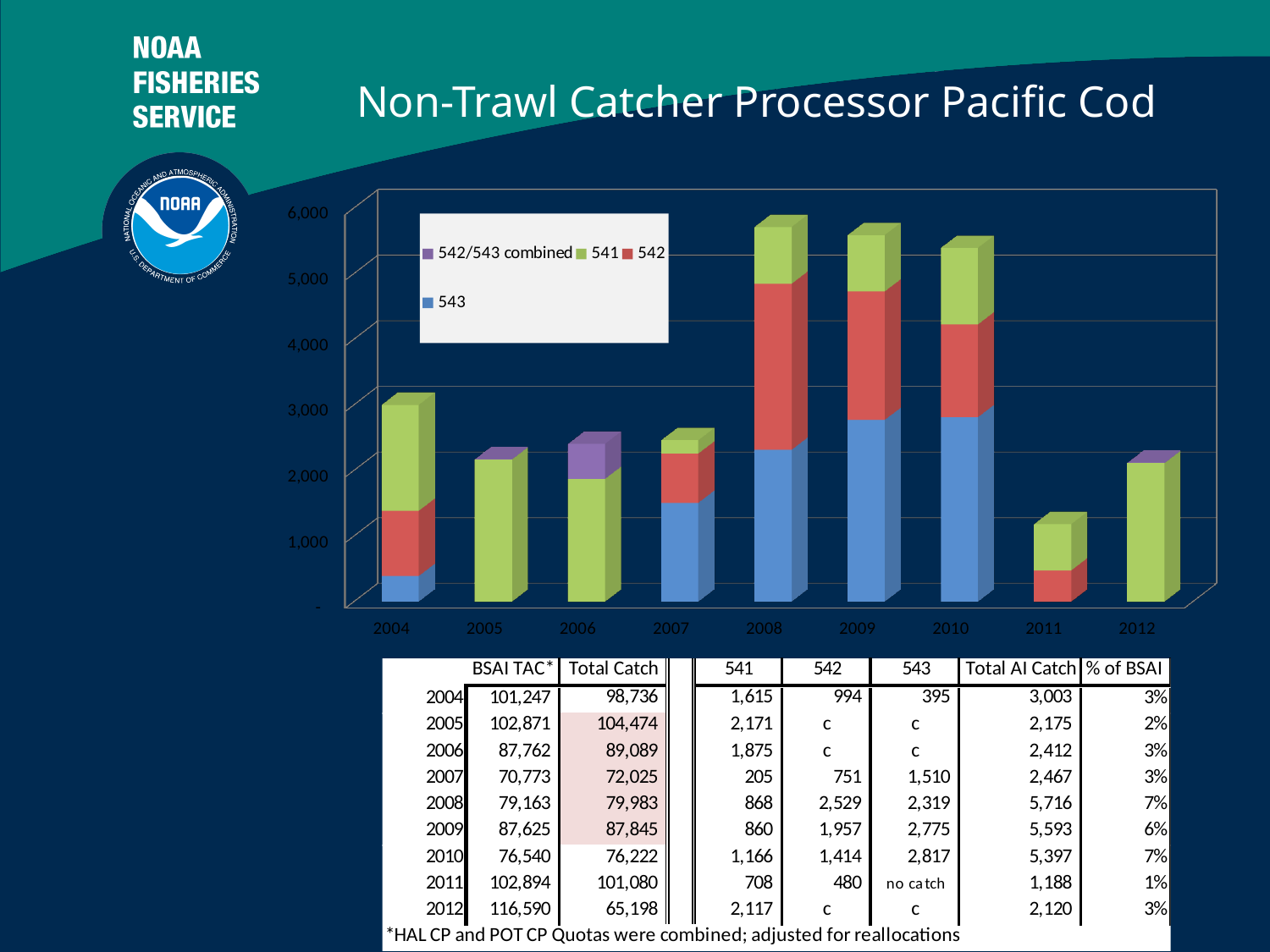
How many years are shown along the x axis of the chart? 9 What is the title of the slide containing the chart? Non-Trawl Catcher Processor Pacific Cod According to the table on the slide, what is the % of BSAI for 2011? 1% Is the total bar for 2011 greater or less than 2,000? less What kind of chart is shown on the slide? stacked bar chart Which year has the taller total bar, 2004 or 2005? 2004 How many series does the chart legend list? 4 Is the total bar for 2008 greater or less than 5,000? greater Is the total bar for 2004 greater or less than 2,000? greater Do the total bars rise or fall from 2008 to 2011? fall According to the table on the slide, what is the Total AI Catch for 2008? 5,716 Which year has the lowest total bar in the chart? 2011